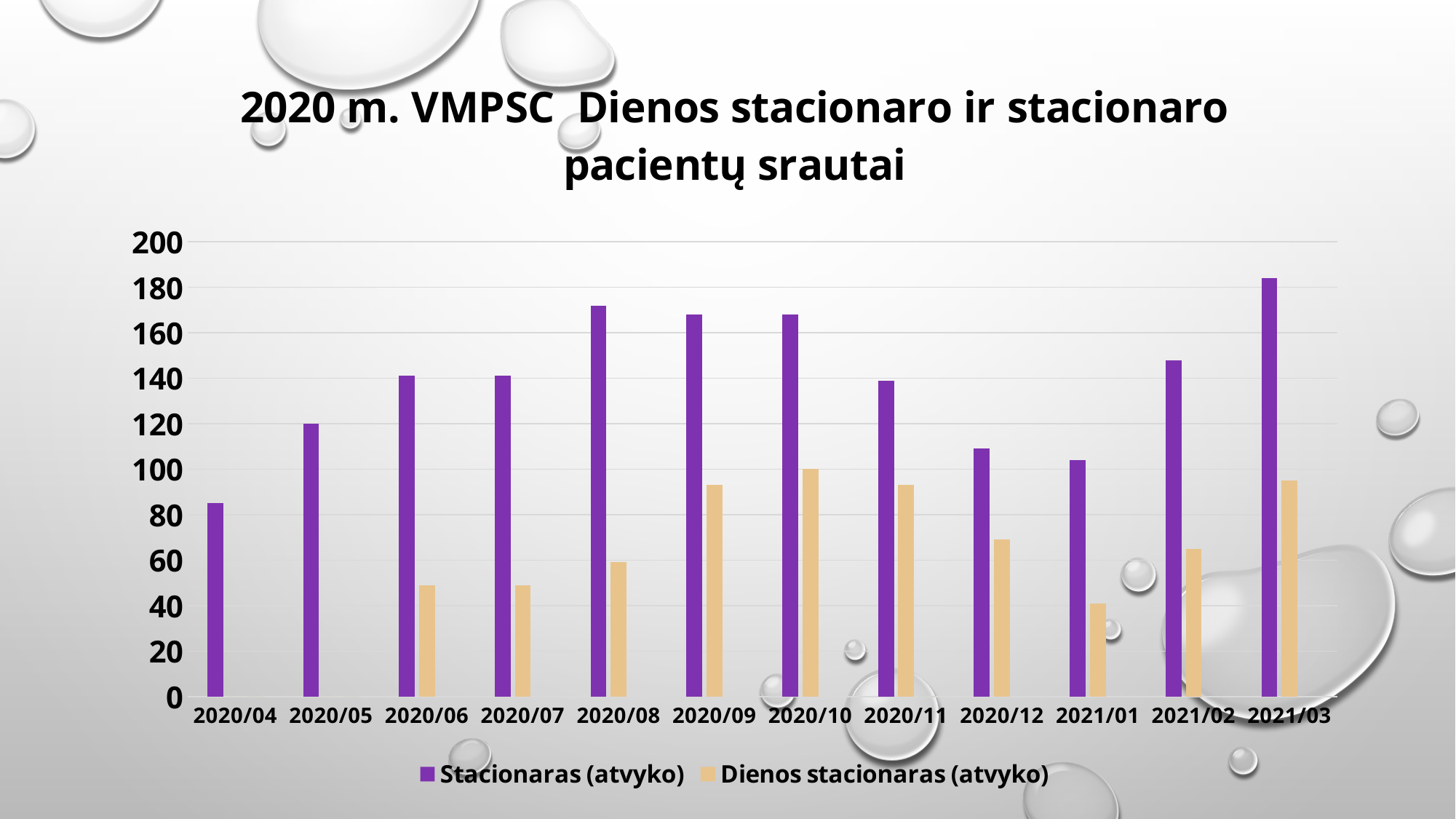
Which colour represents Dienos stacionaras (atvyko) in the legend? tan (light orange) Is the value for Stacionaras (atvyko) in 2020/08 greater or less than 160? greater Which month has the lowest value for Stacionaras (atvyko)? 2020/04 How many months are shown on the x axis? 12 Which is larger: Stacionaras (atvyko) in 2020/08 or Stacionaras (atvyko) in 2020/11? 2020/08 Which month has the highest value for Stacionaras (atvyko)? 2021/03 How many series does the legend list? 2 Is the value for Stacionaras (atvyko) in 2020/04 greater or less than 100? less Is the value for Stacionaras (atvyko) in 2021/03 greater or less than 180? greater What kind of chart is shown on the slide? bar chart